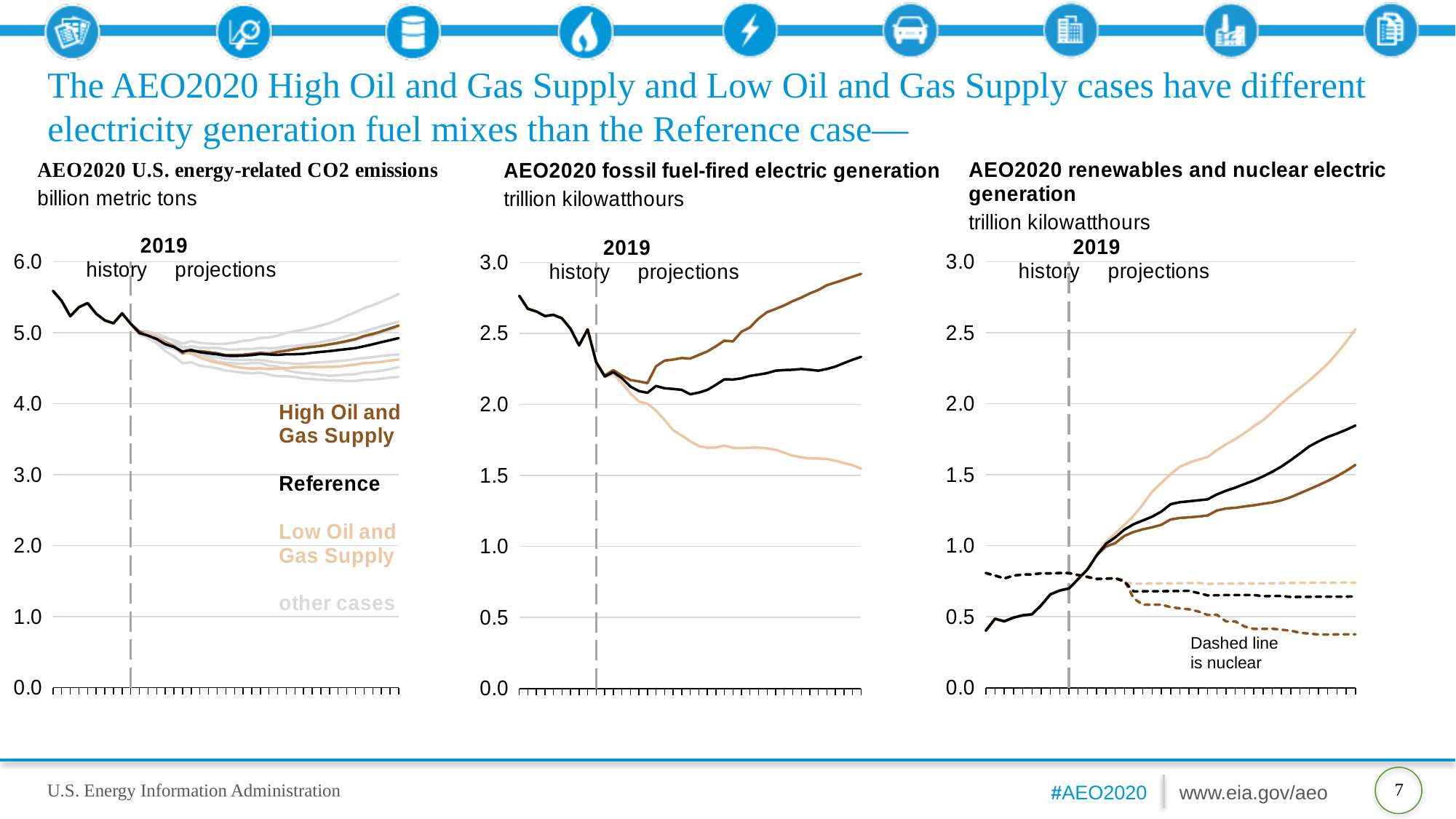
In the AEO2020 renewables and nuclear electric generation chart, what do the dashed lines represent? nuclear In the AEO2020 renewables and nuclear electric generation chart, do the solid renewables lines rise or fall over the projection period? rise What type of chart is the AEO2020 U.S. energy-related CO2 emissions chart? line chart In the AEO2020 fossil fuel-fired electric generation chart, is the High Oil and Gas Supply value at the end of the projection period greater or less than 2.5? greater In the AEO2020 U.S. energy-related CO2 emissions chart, is the Low Oil and Gas Supply value at the end of the projection period greater or less than 5.0? less In the AEO2020 fossil fuel-fired electric generation chart, does the Low Oil and Gas Supply line rise or fall over the projection period? fall In the AEO2020 renewables and nuclear electric generation chart, is the Low Oil and Gas Supply renewables value at the end of the projection period greater or less than 2.0? greater In the AEO2020 fossil fuel-fired electric generation chart, which case is higher at the end of the projection period: High Oil and Gas Supply or Reference? High Oil and Gas Supply In the AEO2020 renewables and nuclear electric generation chart, which solid line is higher at the end of the projection period: Low Oil and Gas Supply or High Oil and Gas Supply? Low Oil and Gas Supply What year marks the boundary between history and projections in the charts? 2019